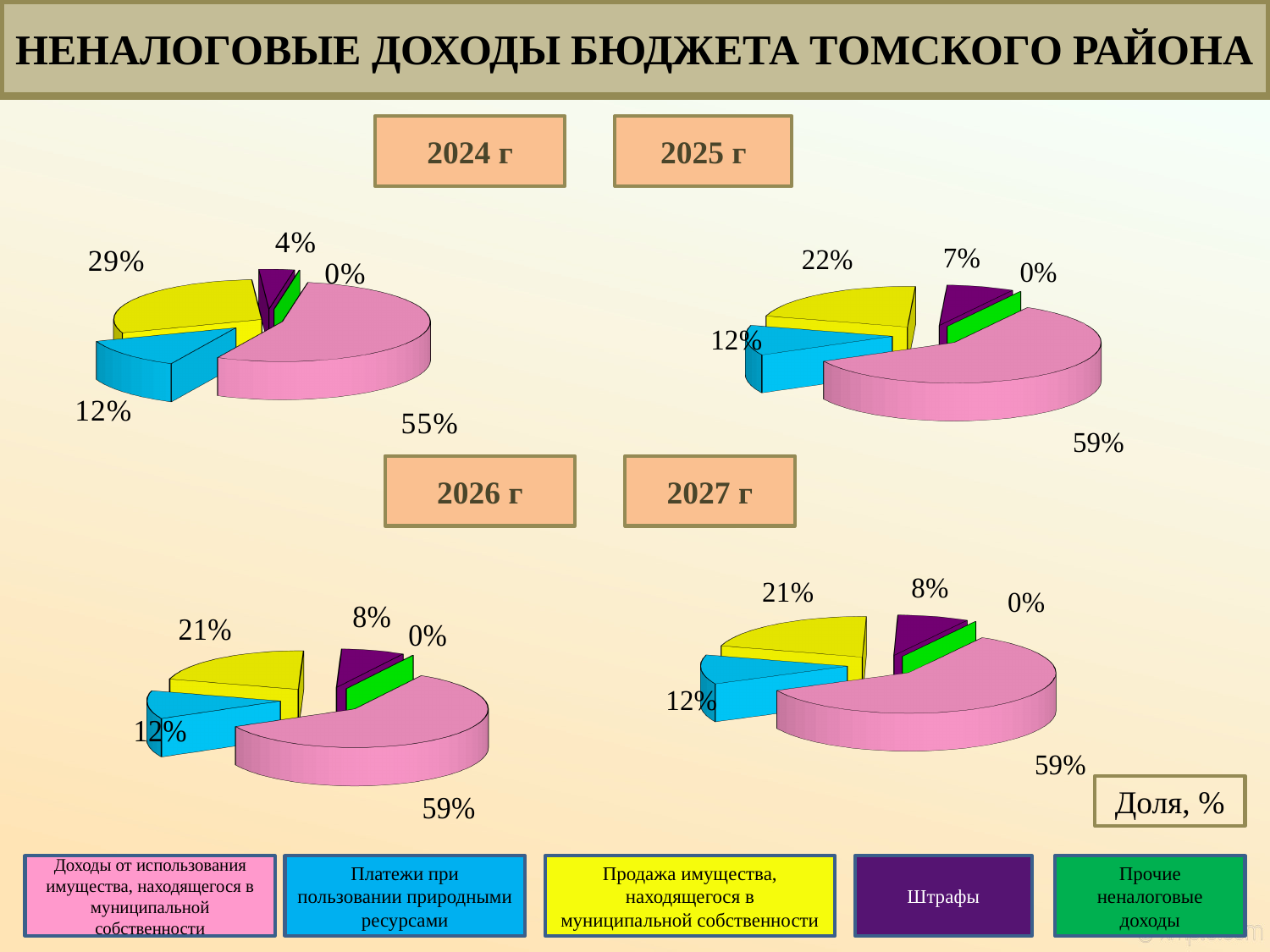
In the 2025 г pie chart, what share is shown for Штрафы (purple slice)? 7% In the 2027 г pie chart, what share is shown for Прочие неналоговые доходы (green slice)? 0% In the 2024 г pie chart, what share is shown for Доходы от использования имущества, находящегося в муниципальной собственности (pink slice)? 55% What type of chart is used for the 2026 г data? Pie chart In the 2027 г pie chart, which category has the smallest share? Прочие неналоговые доходы In the 2026 г pie chart, what share is shown for Платежи при пользовании природными ресурсами (blue slice)? 12% What is the difference between the share of Штрафы in 2027 г and in 2024 г? 4% Which is larger: the share of Продажа имущества, находящегося в муниципальной собственности in 2024 г or in 2025 г? 2024 г How many categories does the legend at the bottom of the slide list? 5 In the 2024 г pie chart, what share is shown for Продажа имущества, находящегося в муниципальной собственности (yellow slice)? 29% In the 2024 г pie chart, which category has the largest share? Доходы от использования имущества, находящегося в муниципальной собственности How many pie charts are shown on the slide? 4